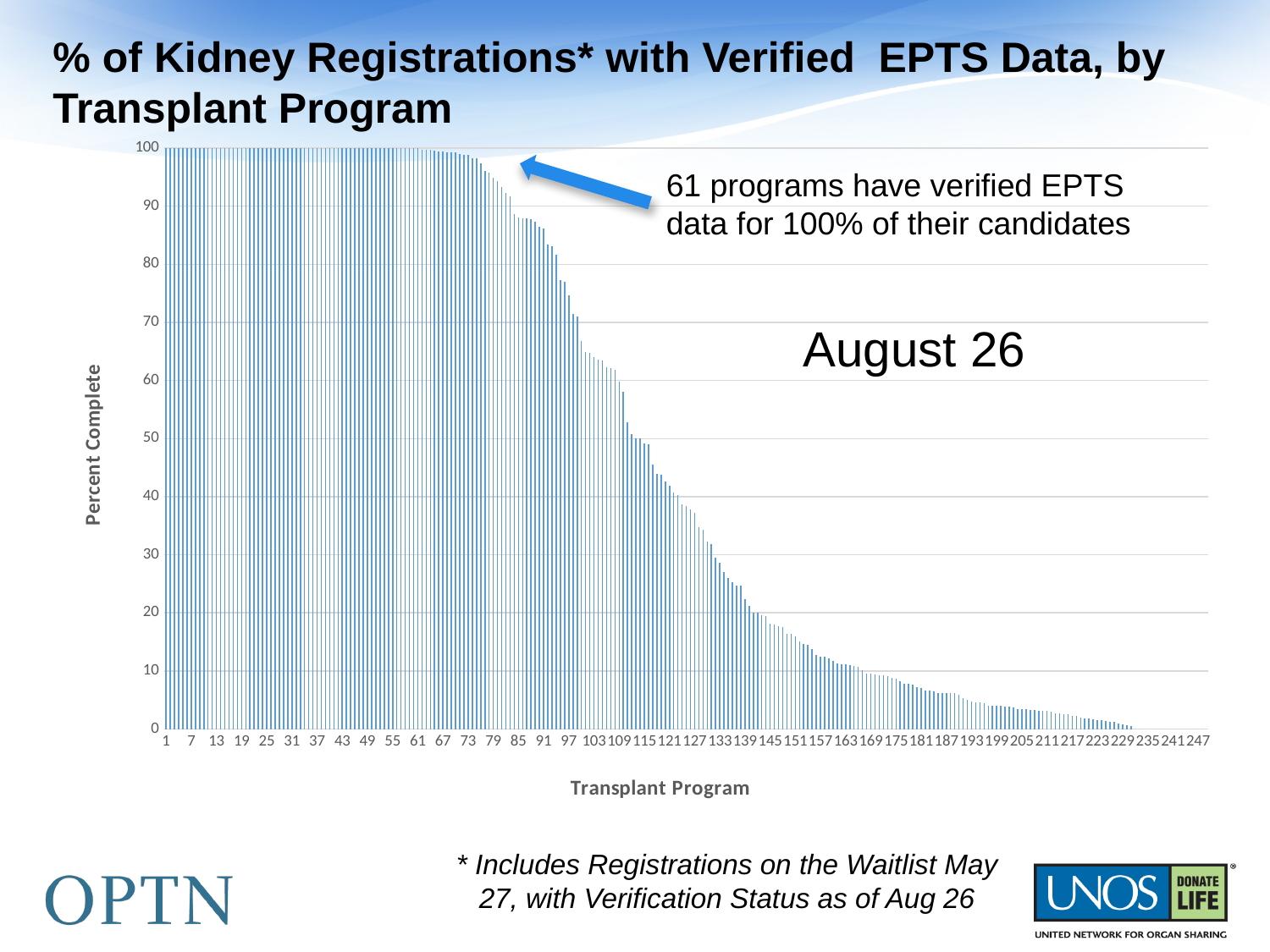
What is the label on the x axis of the chart? Transplant Program What is the percent complete for transplant program 1? 100 Is the value for transplant program 205 greater or less than 10? less Is the value for transplant program 103 greater or less than 50? greater Do the values rise or fall as you move from left to right along the x axis? fall What kind of chart is shown on the slide? bar chart Is the value for transplant program 61 greater or less than 90? greater According to the annotation, how many programs have verified EPTS data for 100% of their candidates? 61 Which has the larger value, transplant program 25 or transplant program 175? transplant program 25 What is the label on the y axis of the chart? Percent Complete